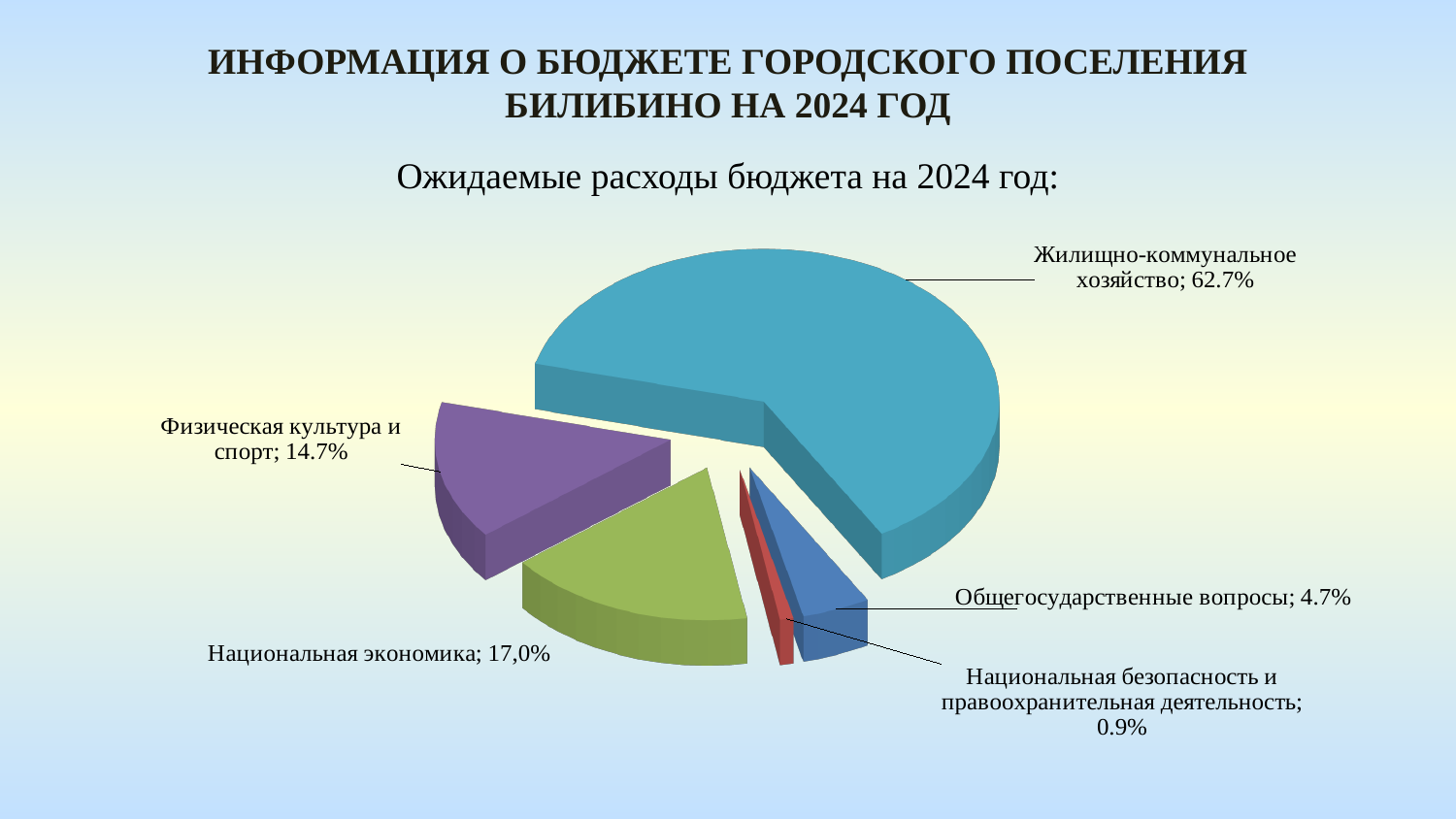
What kind of chart is shown on the slide? Pie chart What share of expected 2024 budget expenditures goes to Жилищно-коммунальное хозяйство? 62.7% What percentage is shown for Физическая культура и спорт? 14.7% What percentage is shown for Общегосударственные вопросы? 4.7% What percentage is shown for Национальная безопасность и правоохранительная деятельность? 0.9% Which category has the smallest share of the pie? Национальная безопасность и правоохранительная деятельность What is the difference between the shares of Общегосударственные вопросы and Национальная безопасность и правоохранительная деятельность? 3.8% What colour is the slice for Жилищно-коммунальное хозяйство? Blue (teal) Which is larger: the share for Национальная экономика or for Физическая культура и спорт? Национальная экономика What percentage is shown for Национальная экономика? 17,0% How many slices does the pie chart have? 5 Which category has the largest share of the pie? Жилищно-коммунальное хозяйство